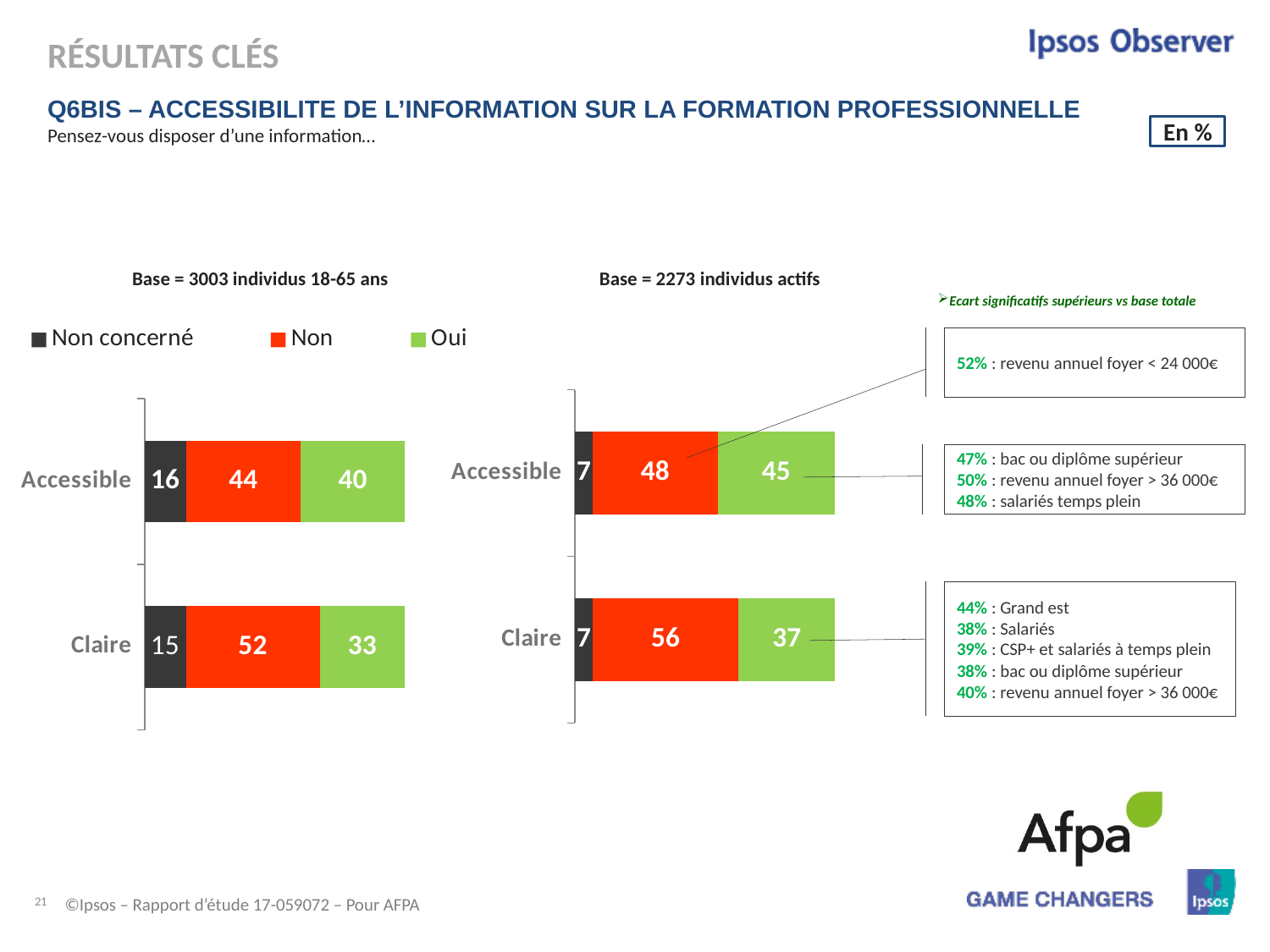
In the chart with Base = 2273 individus actifs, what is the value of the Non segment for Claire? 56 In the chart with Base = 3003 individus 18-65 ans, what is the value of the Non segment for Accessible? 44 In the chart with Base = 3003 individus 18-65 ans, what is the value of the Oui segment for Claire? 33 In the chart with Base = 2273 individus actifs, what is the value of the Oui segment for Accessible? 45 How many categories are shown in the chart with Base = 2273 individus actifs? 2 In the chart with Base = 3003 individus 18-65 ans, which is larger for Accessible: the Non segment or the Oui segment? Non In the chart with Base = 2273 individus actifs, what is the difference between the Oui values for Accessible and Claire? 8 In the chart with Base = 2273 individus actifs, what is the value of the Non concerné segment for Accessible? 7 How many series does the legend list for the charts on this slide? 3 In the chart with Base = 3003 individus 18-65 ans, what is the total of the stacked bar for Accessible? 100 What kind of chart is the chart with Base = 3003 individus 18-65 ans? Stacked bar chart In the chart with Base = 3003 individus 18-65 ans, what is the difference between the Non values for Claire and Accessible? 8